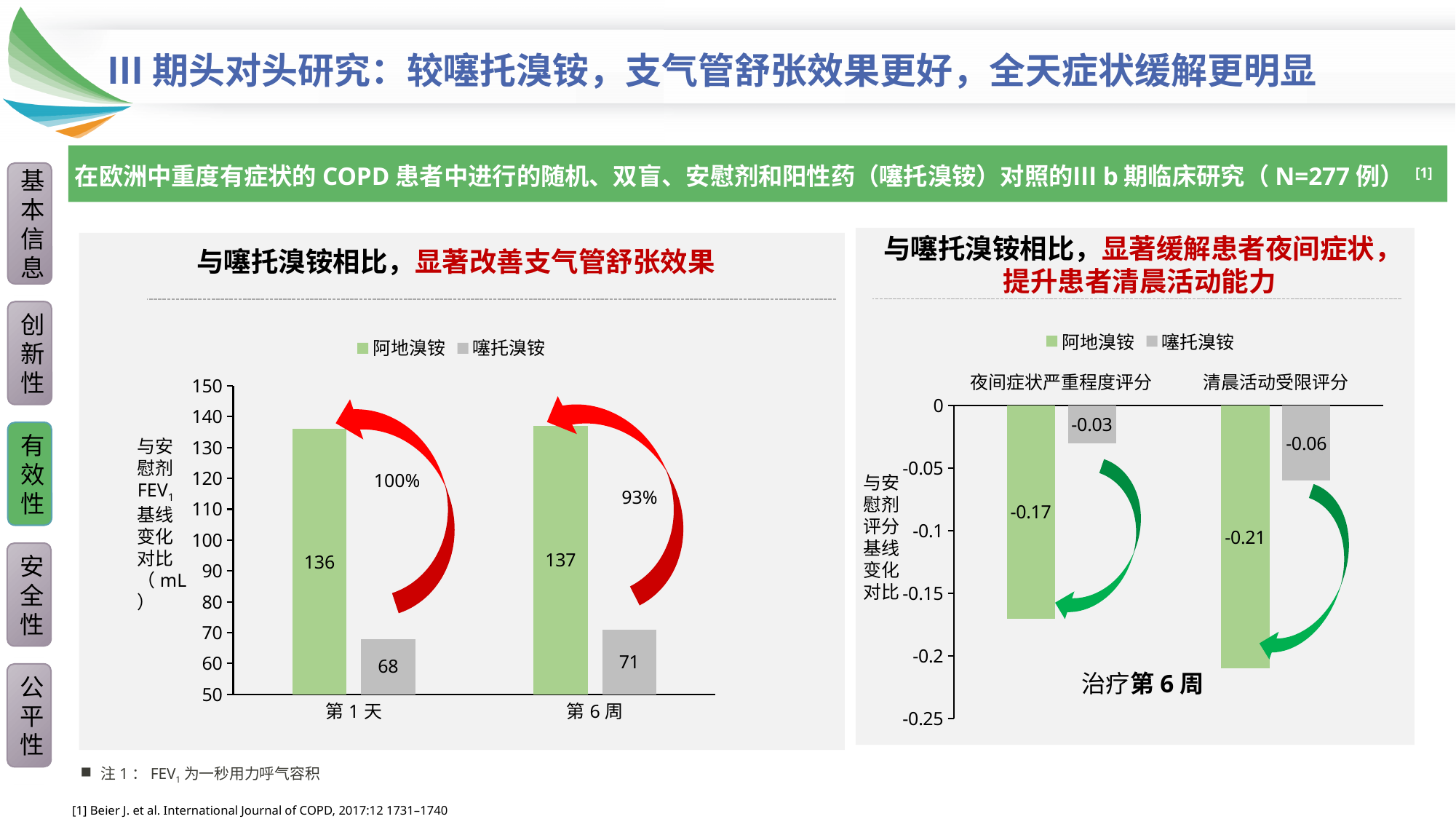
In the left chart (与噻托溴铵相比，显著改善支气管舒张效果), what is the value for 阿地溴铵 on 第 1 天? 136 In the right chart (与噻托溴铵相比，显著缓解患者夜间症状), what is the value for 噻托溴铵 for 清晨活动受限评分? -0.06 In the right chart (与噻托溴铵相比，显著缓解患者夜间症状), what is the value for 阿地溴铵 for 夜间症状严重程度评分? -0.17 In the left chart (与噻托溴铵相比，显著改善支气管舒张效果), how many series does the legend list? 2 In the left chart (与噻托溴铵相比，显著改善支气管舒张效果), how many categories are shown on the x axis? 2 What kind of chart is the left chart (与噻托溴铵相比，显著改善支气管舒张效果)? bar chart In the left chart (与噻托溴铵相比，显著改善支气管舒张效果), what is the value for 噻托溴铵 on 第 6 周? 71 In the right chart (与噻托溴铵相比，显著缓解患者夜间症状), which bar has the lowest value? 阿地溴铵, 清晨活动受限评分 (-0.21) In the right chart (与噻托溴铵相比，显著缓解患者夜间症状), what is the difference between the 阿地溴铵 and 噻托溴铵 values for 清晨活动受限评分? 0.15 In the left chart (与噻托溴铵相比，显著改善支气管舒张效果), what is the difference between 阿地溴铵 and 噻托溴铵 on 第 1 天? 68 In the left chart (与噻托溴铵相比，显著改善支气管舒张效果), which series has the higher value on 第 6 周? 阿地溴铵 In the right chart (与噻托溴铵相比，显著缓解患者夜间症状), what colour are the 阿地溴铵 bars? green